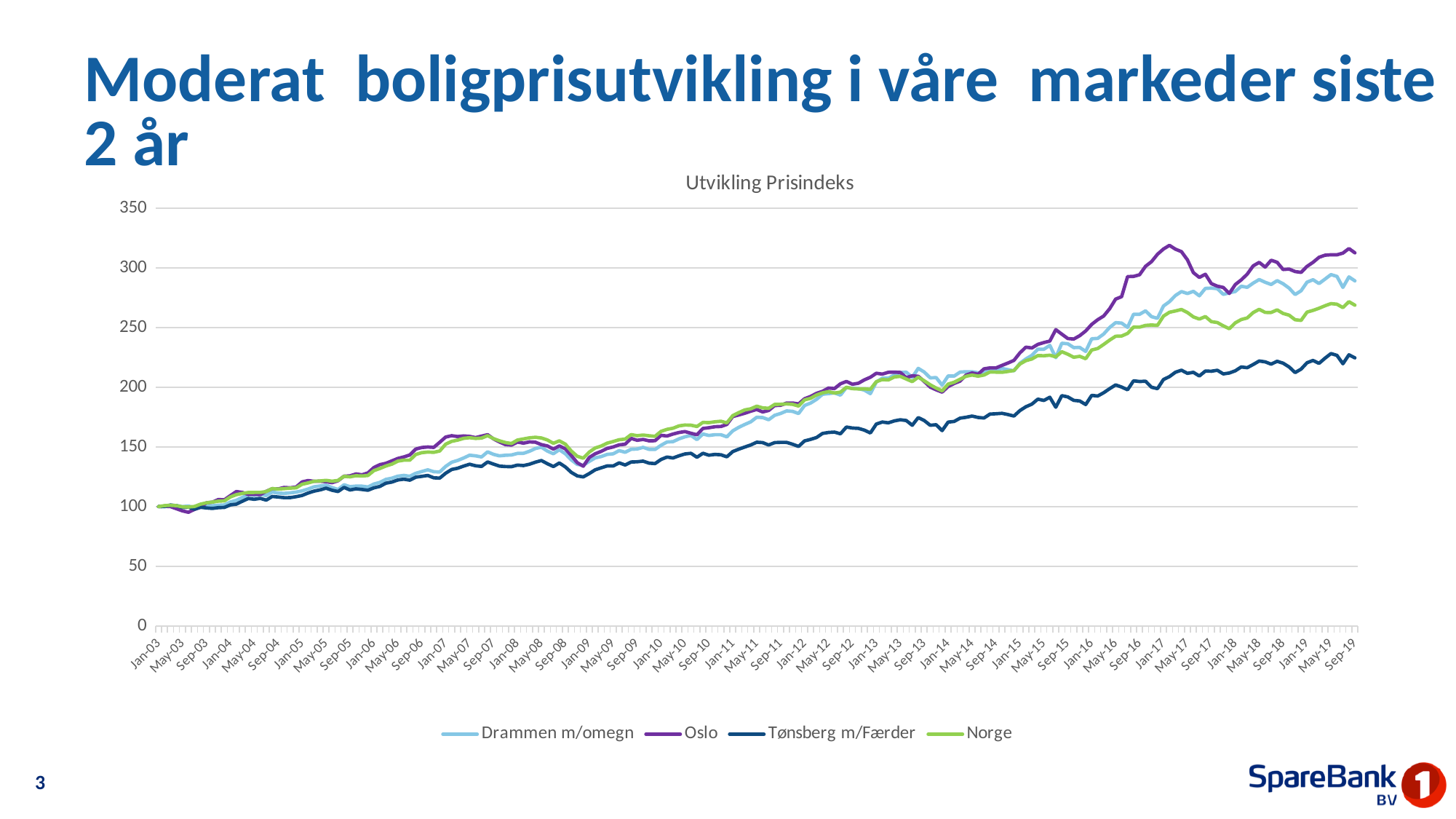
Do the price index values generally rise or fall from Jan-03 to Sep-19? rise What kind of chart is shown on the slide? line chart Which series has the highest value at Sep-19? Oslo Which series is plotted with the dark blue line? Tønsberg m/Færder At Sep-19, which is larger: the value for Norge or the value for Tønsberg m/Færder? Norge Is the value for Norge at Sep-19 greater or less than 250? greater Is the value for Oslo at Sep-19 greater or less than 300? greater Is the value for Tønsberg m/Færder at Sep-19 greater or less than 250? less What is the title of the chart? Utvikling Prisindeks How many series does the legend of the chart list? 4 At what index value do all four series start in Jan-03? 100 Which series has the lowest value at Sep-19? Tønsberg m/Færder